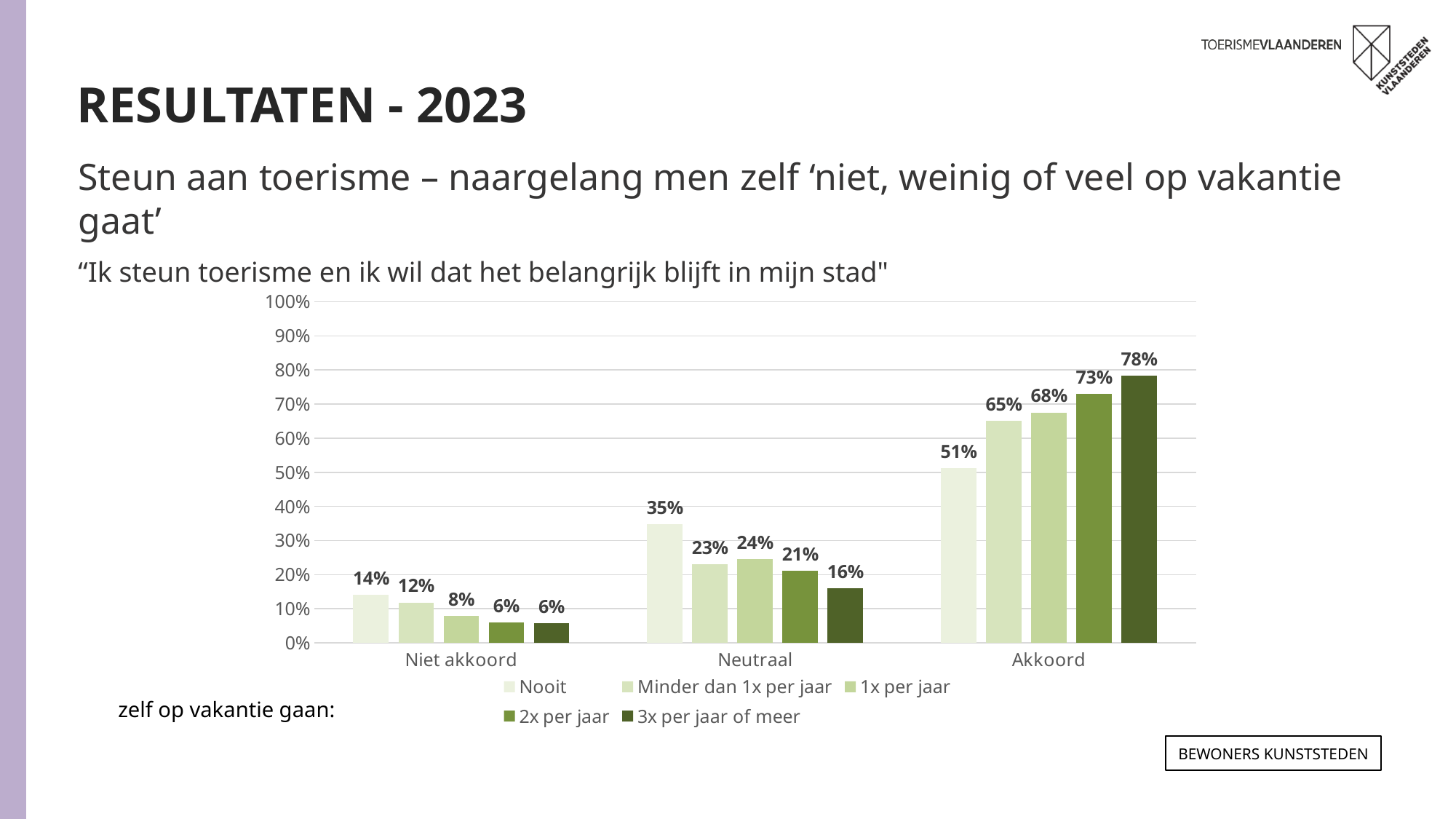
Which series has the highest value in the 'Akkoord' category? 3x per jaar of meer How many series does the legend list? 5 How many categories are shown on the x axis? 3 Which series has the lowest value in the 'Neutraal' category? 3x per jaar of meer Which is larger in the 'Neutraal' category: 'Nooit' or 'Minder dan 1x per jaar'? Nooit Across the series from 'Nooit' to '3x per jaar of meer', do the values in the 'Akkoord' category rise or fall? Rise What statement is the chart about, as shown above it? "Ik steun toerisme en ik wil dat het belangrijk blijft in mijn stad" What is the value for '3x per jaar of meer' in the 'Niet akkoord' category? 6% What is the difference between the '3x per jaar of meer' and 'Nooit' values in the 'Akkoord' category? 27% What is the value for 'Nooit' in the 'Akkoord' category? 51% What is the value for '1x per jaar' in the 'Neutraal' category? 24% What kind of chart is shown on the slide? Bar chart